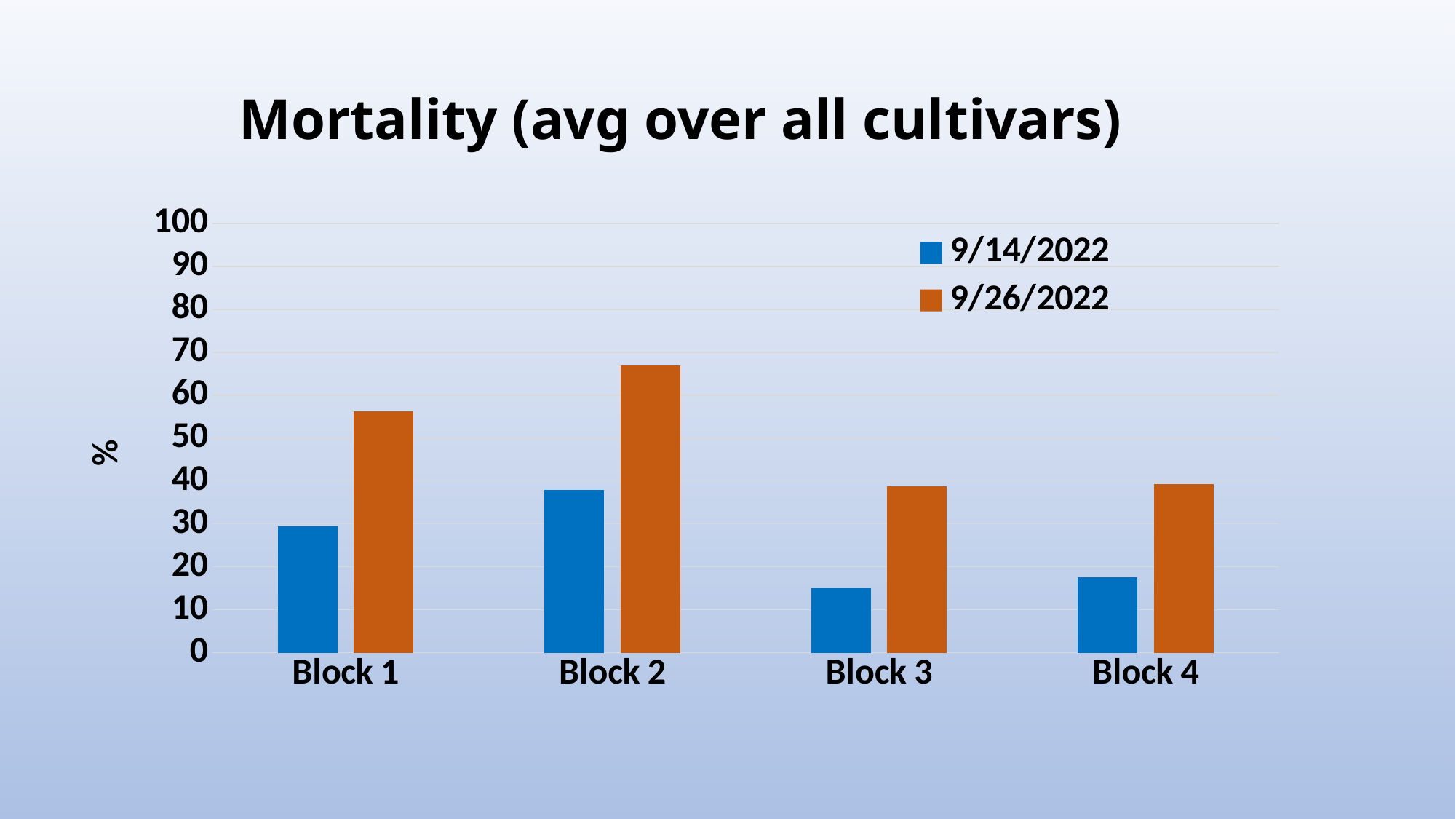
Is the 9/26/2022 value for Block 1 greater or less than 50? greater Is the 9/14/2022 value for Block 3 greater or less than 20? less Which block has the highest mortality for 9/26/2022? Block 2 Is the 9/14/2022 value for Block 2 greater or less than 30? greater What is the title of the chart? Mortality (avg over all cultivars) What type of chart is shown on the slide? bar chart How many series does the legend list? 2 For Block 1, which date has the higher mortality, 9/14/2022 or 9/26/2022? 9/26/2022 How many blocks are shown on the x axis? 4 Which block has the highest mortality for 9/14/2022? Block 2 For 9/14/2022, which block has higher mortality, Block 1 or Block 3? Block 1